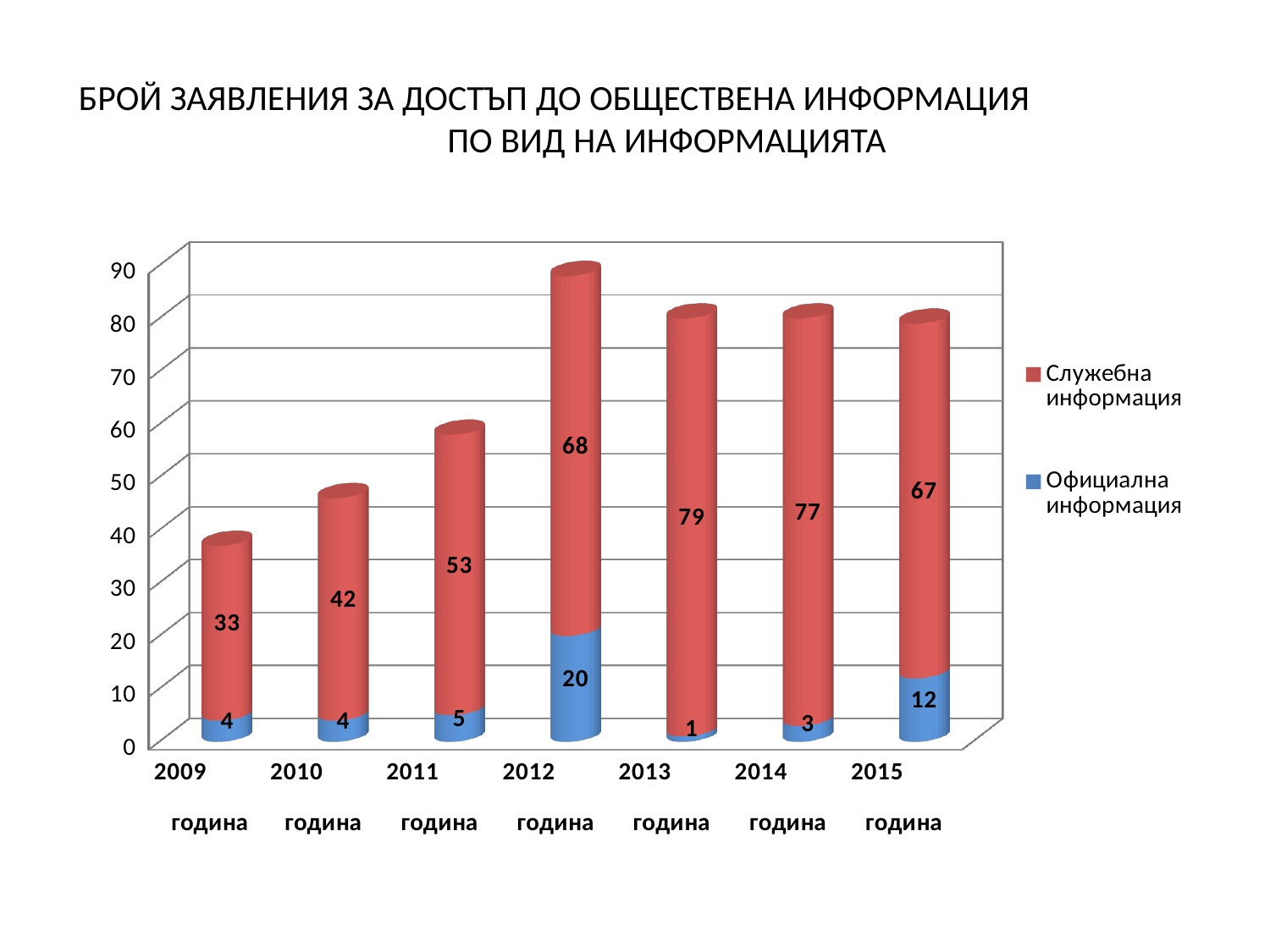
Which is larger: Официална информация in 2012 година or in 2015 година? 2012 година Which year has the lowest value for Официална информация? 2013 година Which colour represents Официална информация in the chart? Blue How many series does the legend list? 2 What is the total of the stacked bar for 2012 година? 88 What is the value for Служебна информация in 2012 година? 68 Which year has the highest value for Служебна информация? 2013 година What is the value for Официална информация in 2015 година? 12 What kind of chart is shown on the slide? Stacked bar chart What is the total of the stacked bar for 2009 година? 37 How many years are shown on the x axis? 7 What is the difference between the Служебна информация values for 2012 година and 2009 година? 35